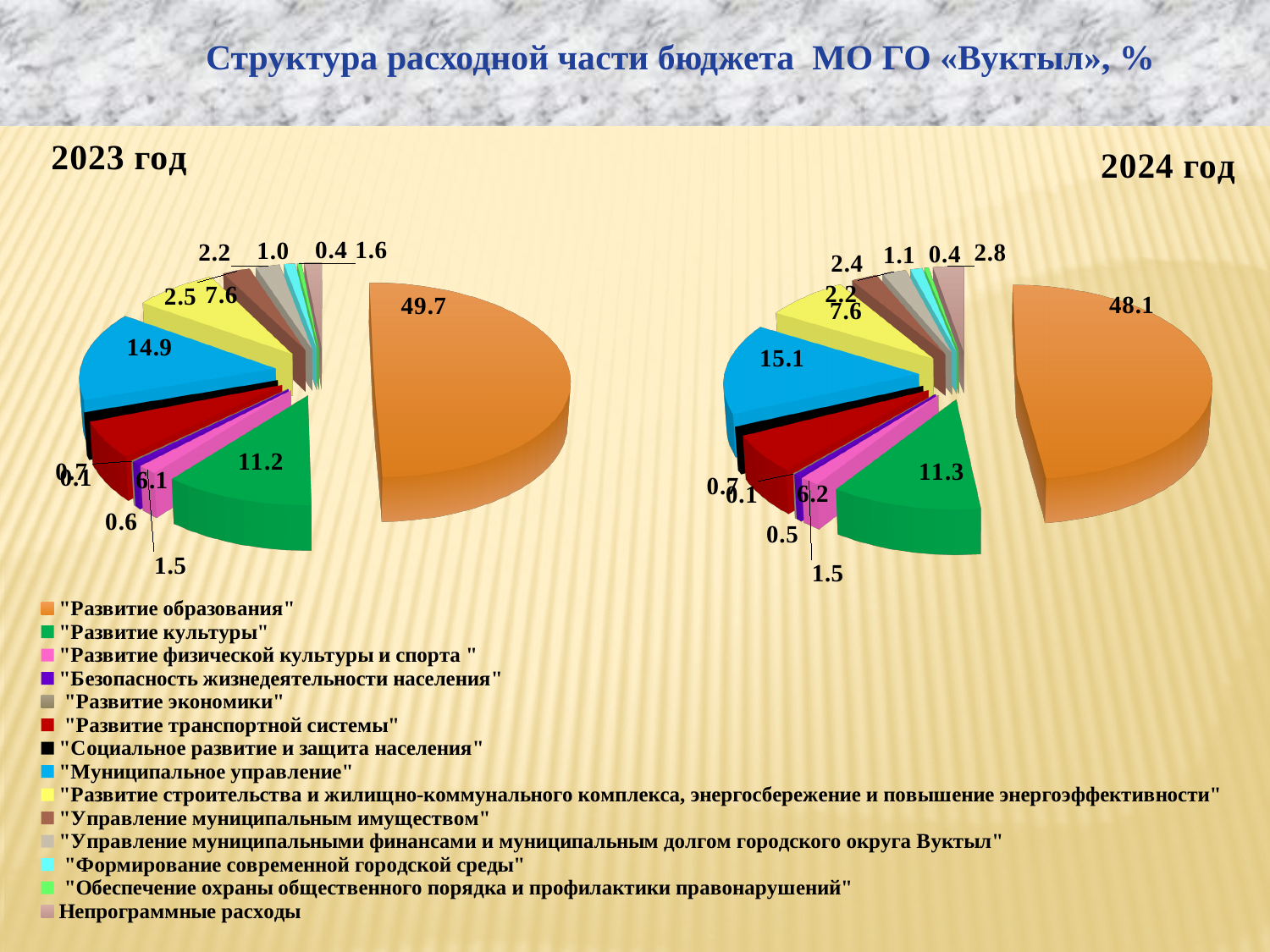
On the 2023 год chart, what is the value for "Развитие образования"? 49.7 What is the title of the slide? Структура расходной части бюджета МО ГО «Вуктыл», % How many charts are on the slide? 2 On the 2024 год chart, what is the value for "Развитие образования"? 48.1 On the 2023 год chart, what is the value for "Развитие культуры"? 11.2 How many categories does the legend list? 14 On the 2024 год chart, what is the value for "Развитие строительства и жилищно-коммунального комплекса, энергосбережение и повышение энергоэффективности"? 7.6 On the 2024 год chart, what is the value for "Муниципальное управление"? 15.1 On the 2023 год chart, which category has the largest slice? "Развитие образования" By how much does the value for "Развитие образования" on the 2023 год chart exceed the value on the 2024 год chart? 1.6 What kind of chart is used on this slide? Pie chart Is the value for "Муниципальное управление" larger on the 2023 год chart or the 2024 год chart? 2024 год